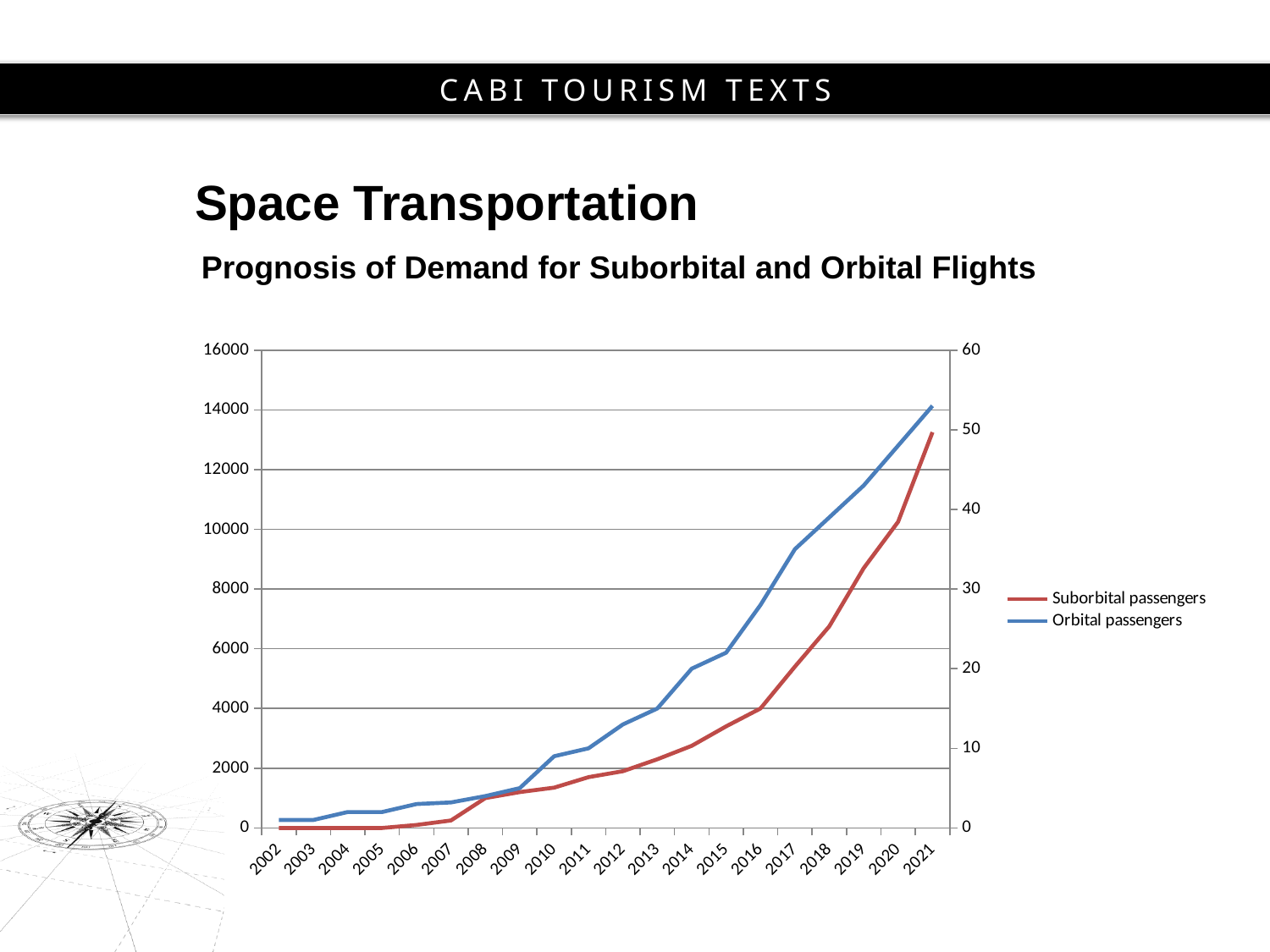
Which year has the highest value for Orbital passengers? 2021 Is the value for Suborbital passengers in 2021 greater or less than 12000 on the left axis? greater Is the value for Orbital passengers in 2013 greater or less than 20 on the right axis? less What colour is the line for Orbital passengers? blue Is the value for Orbital passengers in 2017 greater or less than 30 on the right axis? greater Do the Orbital passengers values rise or fall from 2002 to 2021? rise How many series does the legend list? 2 What kind of chart is shown on the slide? line chart Do the Suborbital passengers values rise or fall from 2002 to 2021? rise Which year has the highest value for Suborbital passengers? 2021 How many years are shown along the x axis? 20